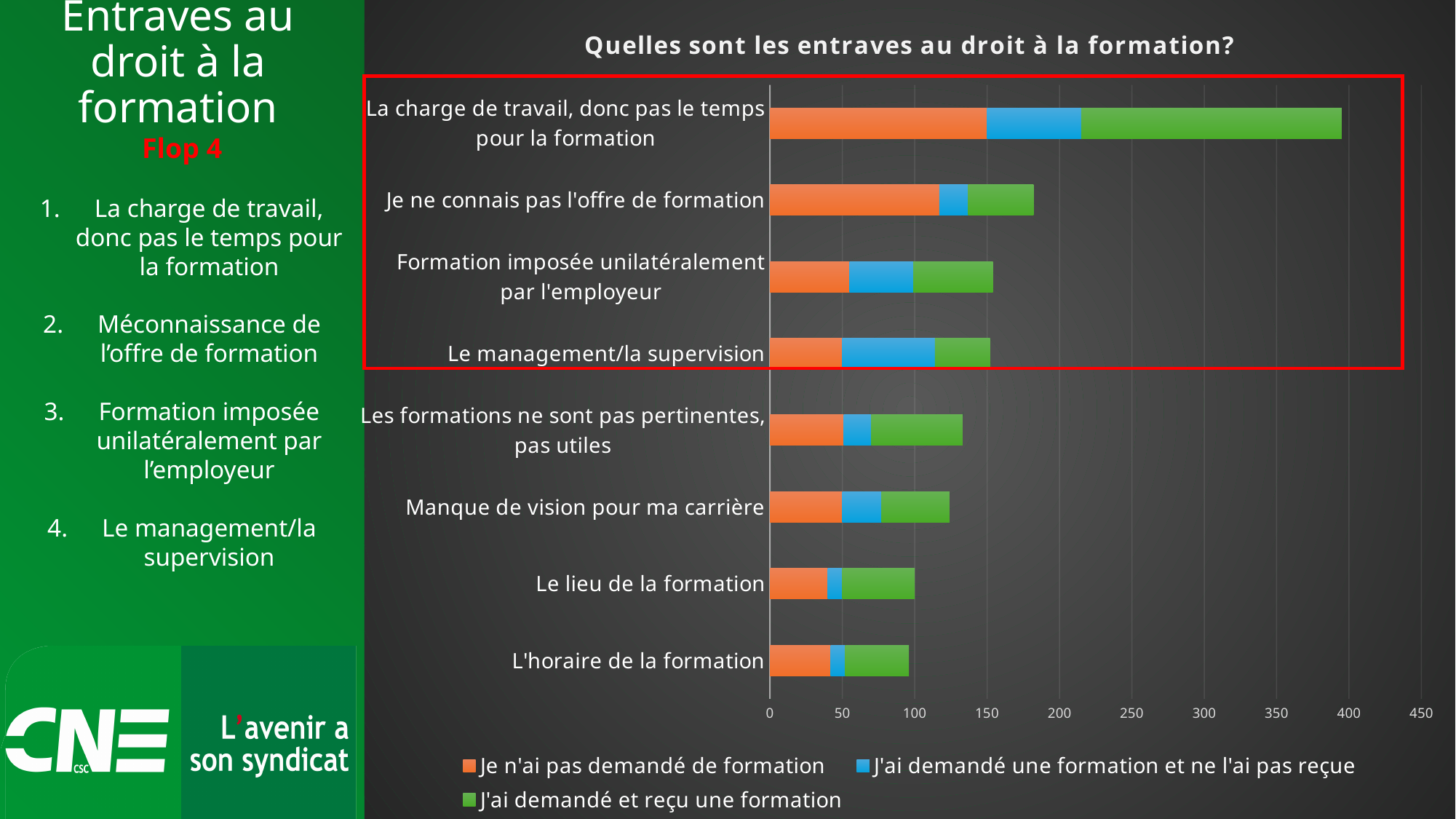
How many categories (obstacles) are plotted in the chart? 8 Which series is shown in green in the chart legend? J'ai demandé et reçu une formation What kind of chart is shown on the slide? Stacked bar chart Is the total bar for 'Les formations ne sont pas pertinentes, pas utiles' greater or less than 150? less How many series does the chart legend list? 3 What is the title of the chart? Quelles sont les entraves au droit à la formation? Which has the longer total bar: 'Je ne connais pas l'offre de formation' or 'Formation imposée unilatéralement par l'employeur'? Je ne connais pas l'offre de formation Which category has the longest total bar in the chart? La charge de travail, donc pas le temps pour la formation Is the total bar for 'Manque de vision pour ma carrière' greater or less than 100? greater Is the total bar for 'Je ne connais pas l'offre de formation' greater or less than 150? greater